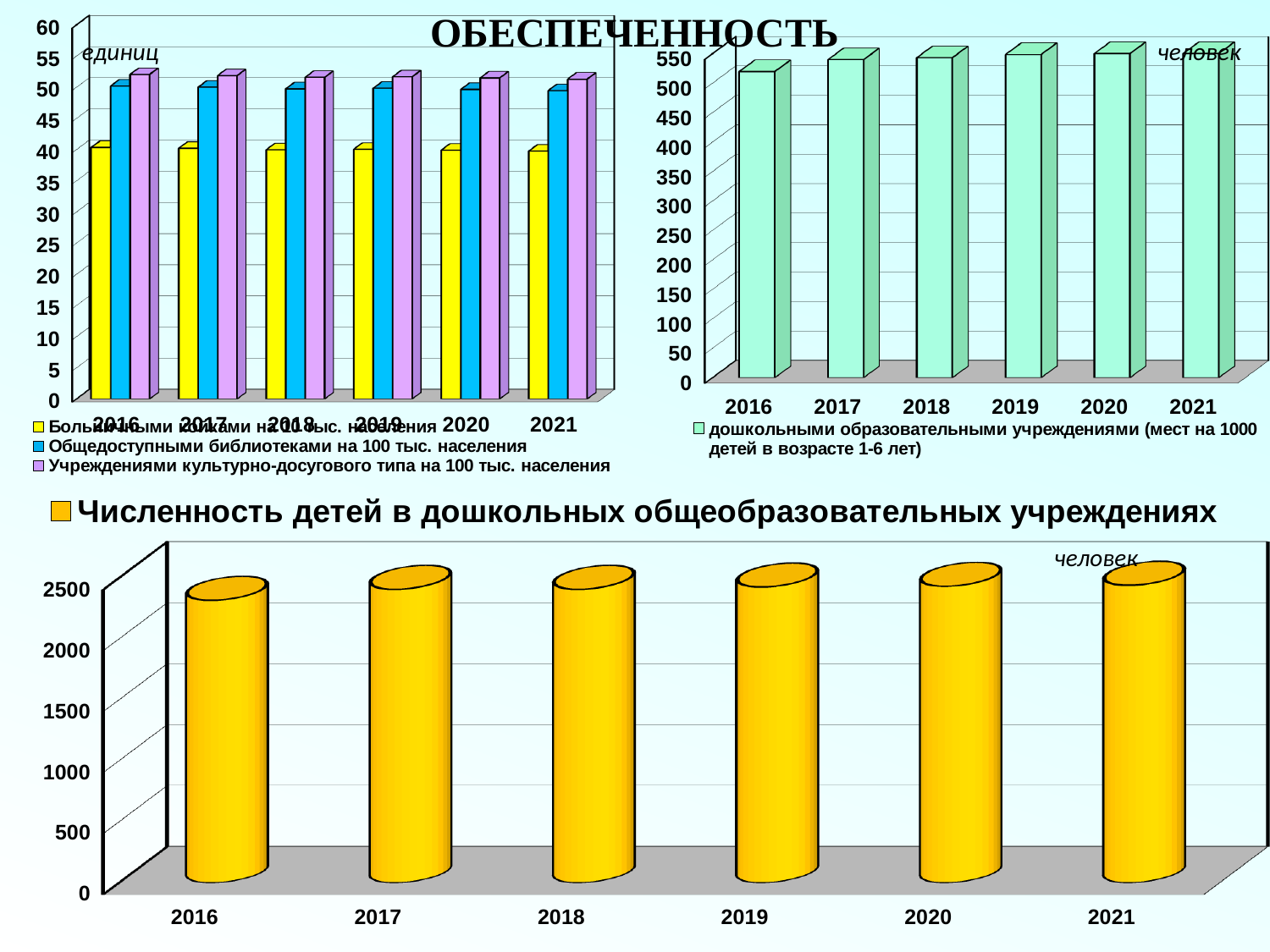
In the bottom chart, is the value for 2016 greater or less than 2000? greater What kind of chart is the top-left chart on the slide? bar chart In the top-left chart, which is larger in 2016: 'Больничными койками на 10 тыс. населения' or 'Общедоступными библиотеками на 100 тыс. населения'? Общедоступными библиотеками на 100 тыс. населения In the top-right chart, is the value for 2016 greater or less than 550? less In the top-right chart, do the values rise or fall from 2016 to 2021? rise What is the title of the bottom chart? Численность детей в дошкольных общеобразовательных учреждениях How many years are shown on the x axis of the top-left chart? 6 In the top-right chart, is the value for 2016 greater or less than 500? greater How many series does the legend of the top-left chart list? 3 How many years are shown on the x axis of the bottom chart? 6